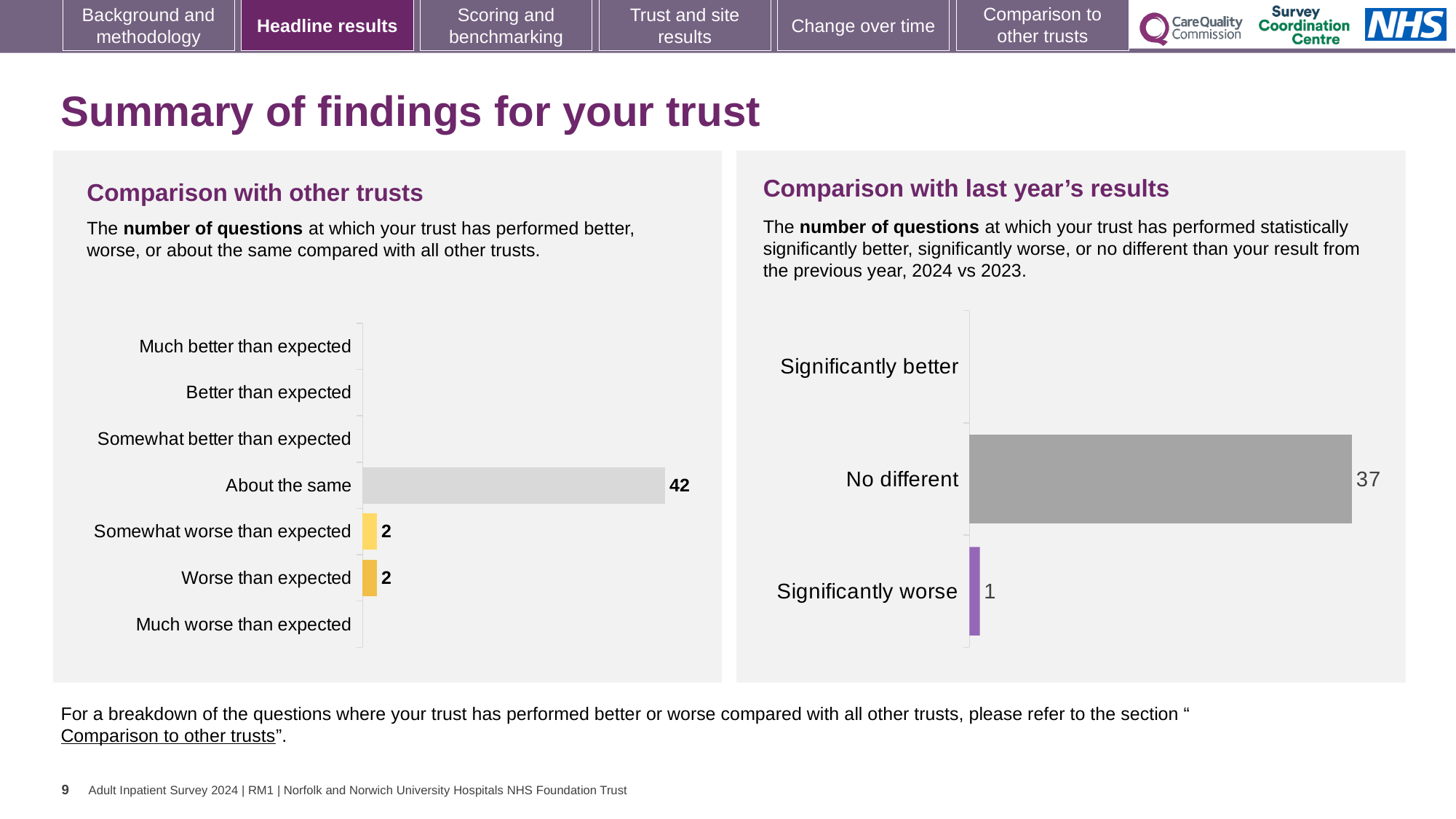
In the 'Comparison with other trusts' chart, how many questions were 'About the same'? 42 In the 'Comparison with last year's results' chart, which category has the highest value? No different In the 'Comparison with other trusts' chart, how many categories are listed on the axis? 7 What type of chart is the 'Comparison with other trusts' chart? Bar chart In the 'Comparison with other trusts' chart, how many questions were 'Somewhat worse than expected'? 2 In the 'Comparison with other trusts' chart, which category has the highest value? About the same In the 'Comparison with last year's results' chart, how many questions were 'Significantly worse'? 1 In the 'Comparison with last year's results' chart, how many categories are listed on the axis? 3 In the 'Comparison with other trusts' chart, what is the difference between 'About the same' and 'Worse than expected'? 40 In the 'Comparison with last year's results' chart, how many questions were 'No different'? 37 In the 'Comparison with other trusts' chart, how many questions were 'Worse than expected'? 2 In the 'Comparison with last year's results' chart, what is the difference between 'No different' and 'Significantly worse'? 36